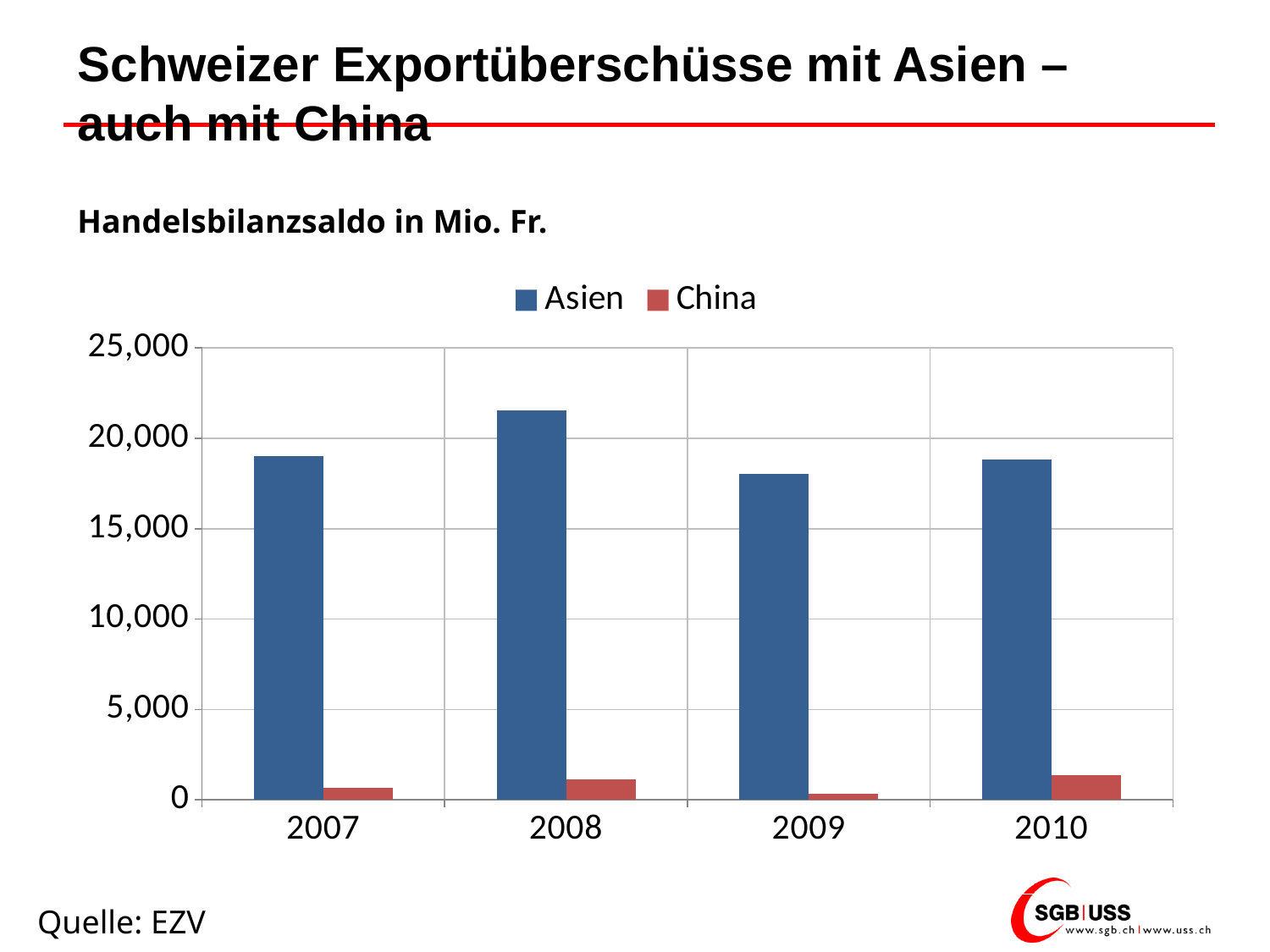
Is the value for Asien in 2009 greater or less than 20,000? less What kind of chart is shown on the slide? bar chart In which year is the value for China lowest? 2009 In which year is the value for Asien highest? 2008 What unit is given in the chart subtitle for the Handelsbilanzsaldo? Mio. Fr. How many years are shown on the x axis? 4 How many series does the legend list? 2 Which is larger in 2010, the value for Asien or for China? Asien Is the value for China in 2008 greater or less than 5,000? less Does the value for Asien rise or fall from 2008 to 2009? fall Is the value for Asien in 2008 greater or less than 20,000? greater Which is larger, the value for Asien in 2008 or in 2007? 2008